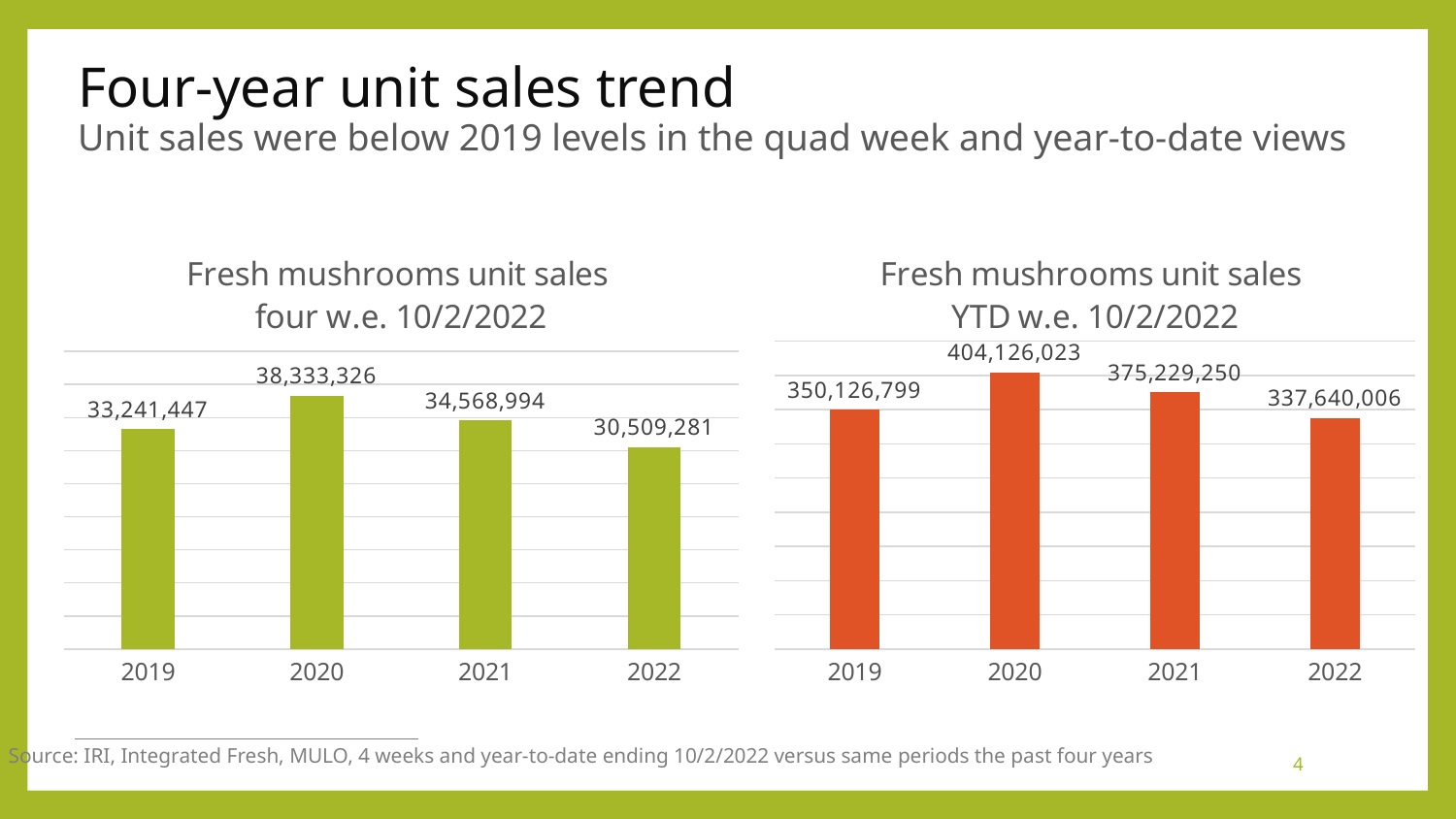
What kind of chart is the 'Fresh mushrooms unit sales four w.e. 10/2/2022' chart? Bar chart In the 'Fresh mushrooms unit sales four w.e. 10/2/2022' chart, what is the value for 2019? 33,241,447 In the 'Fresh mushrooms unit sales YTD w.e. 10/2/2022' chart, which year has the lowest value? 2022 In the 'Fresh mushrooms unit sales four w.e. 10/2/2022' chart, what is the difference between the 2020 and 2022 values? 7,824,045 In the 'Fresh mushrooms unit sales YTD w.e. 10/2/2022' chart, do the values rise or fall from 2020 to 2022? Fall In the 'Fresh mushrooms unit sales YTD w.e. 10/2/2022' chart, what is the value for 2021? 375,229,250 In the 'Fresh mushrooms unit sales YTD w.e. 10/2/2022' chart, what is the difference between the 2020 and 2019 values? 53,999,224 In the 'Fresh mushrooms unit sales four w.e. 10/2/2022' chart, which is larger, the value for 2019 or the value for 2021? 2021 How many years are shown in the 'Fresh mushrooms unit sales YTD w.e. 10/2/2022' chart? 4 In the 'Fresh mushrooms unit sales YTD w.e. 10/2/2022' chart, what is the value for 2022? 337,640,006 In the 'Fresh mushrooms unit sales four w.e. 10/2/2022' chart, what is the value for 2022? 30,509,281 In the 'Fresh mushrooms unit sales four w.e. 10/2/2022' chart, which year has the highest value? 2020